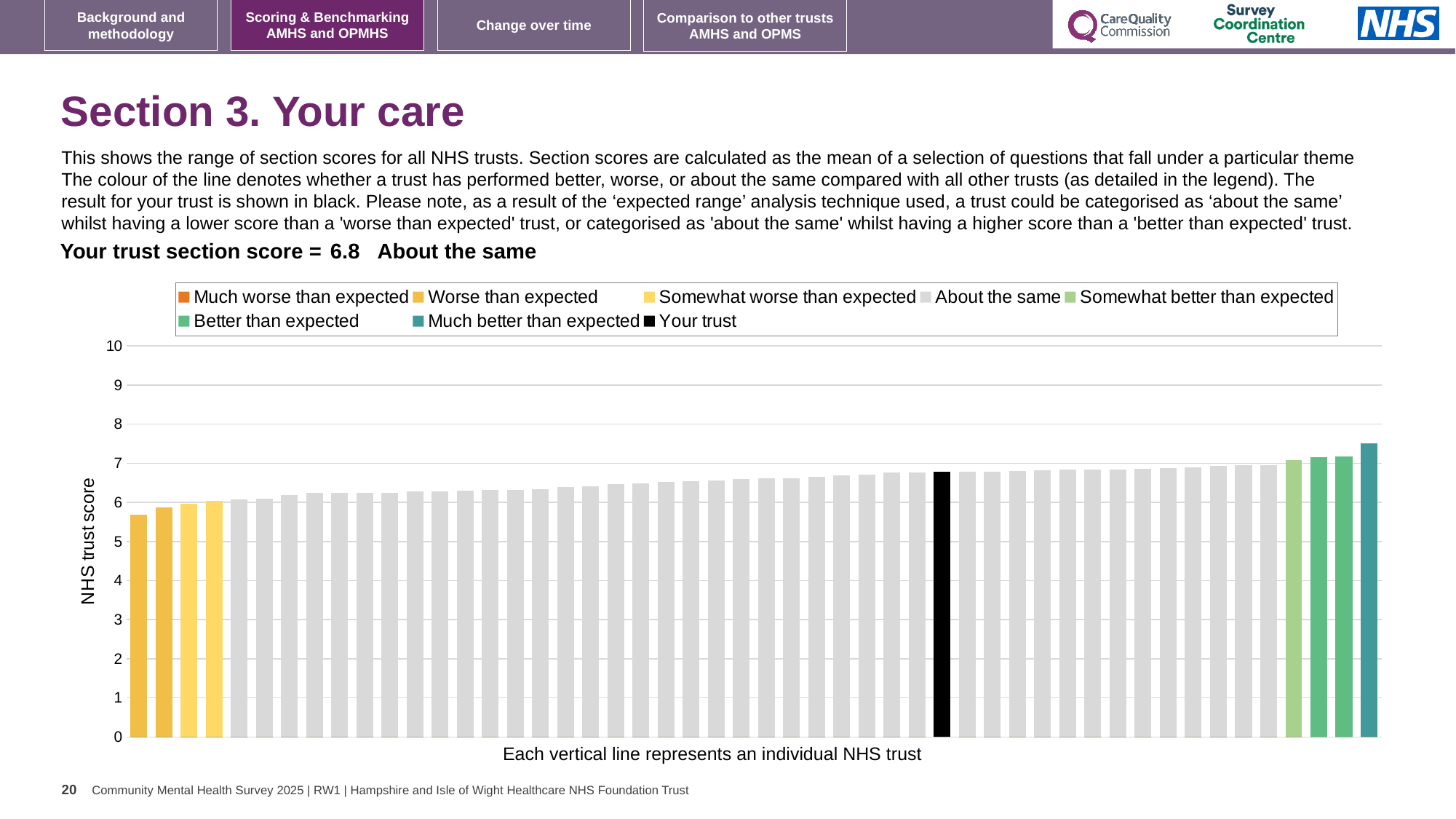
Which of the two is larger: the rightmost bar or the black bar for your trust? The rightmost bar Do the bar values rise or fall from left to right along the x axis? Rise What is the section score for your trust shown on the slide? 6.8 Is the value for your trust (the black bar) greater or less than 6? greater Is the value for the rightmost bar greater or less than 7? greater What is the label on the vertical axis of the chart? NHS trust score Is the value for the leftmost bar greater or less than 6? less Which category is your trust's section score placed in, according to the slide? About the same What kind of chart is shown on the slide? Bar chart How many entries does the chart legend list? 8